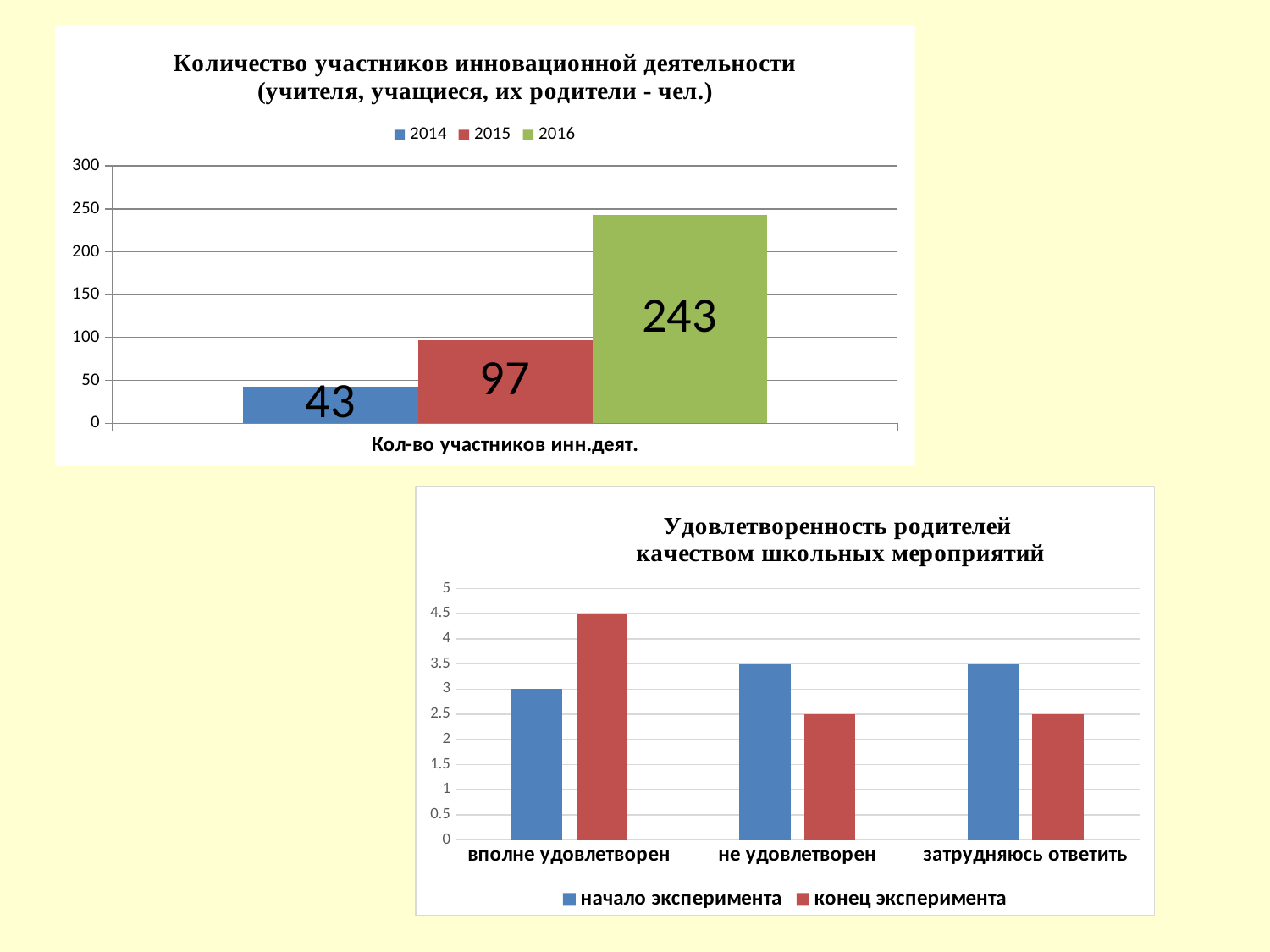
In the top chart (Количество участников инновационной деятельности), what is the value for 2014? 43 In the top chart (Количество участников инновационной деятельности), how many series does the legend list? 3 In the bottom chart (Удовлетворенность родителей качеством школьных мероприятий), which series is larger in the 'затрудняюсь ответить' category, 'начало эксперимента' or 'конец эксперимента'? начало эксперимента In the bottom chart (Удовлетворенность родителей качеством школьных мероприятий), what kind of chart is it? bar chart In the bottom chart (Удовлетворенность родителей качеством школьных мероприятий), is the value for 'конец эксперимента' in the 'вполне удовлетворен' category greater or less than 4? greater In the top chart (Количество участников инновационной деятельности), which year has the highest value? 2016 In the bottom chart (Удовлетворенность родителей качеством школьных мероприятий), what colour are the 'конец эксперимента' bars? red In the top chart (Количество участников инновационной деятельности), do the values rise or fall from 2014 to 2016? rise In the bottom chart (Удовлетворенность родителей качеством школьных мероприятий), is the value for 'конец эксперимента' in the 'не удовлетворен' category greater or less than 3? less In the top chart (Количество участников инновационной деятельности), what is the value for 2016? 243 In the bottom chart (Удовлетворенность родителей качеством школьных мероприятий), how many categories are shown on the x axis? 3 In the top chart (Количество участников инновационной деятельности), what is the difference between the 2016 and 2015 values? 146